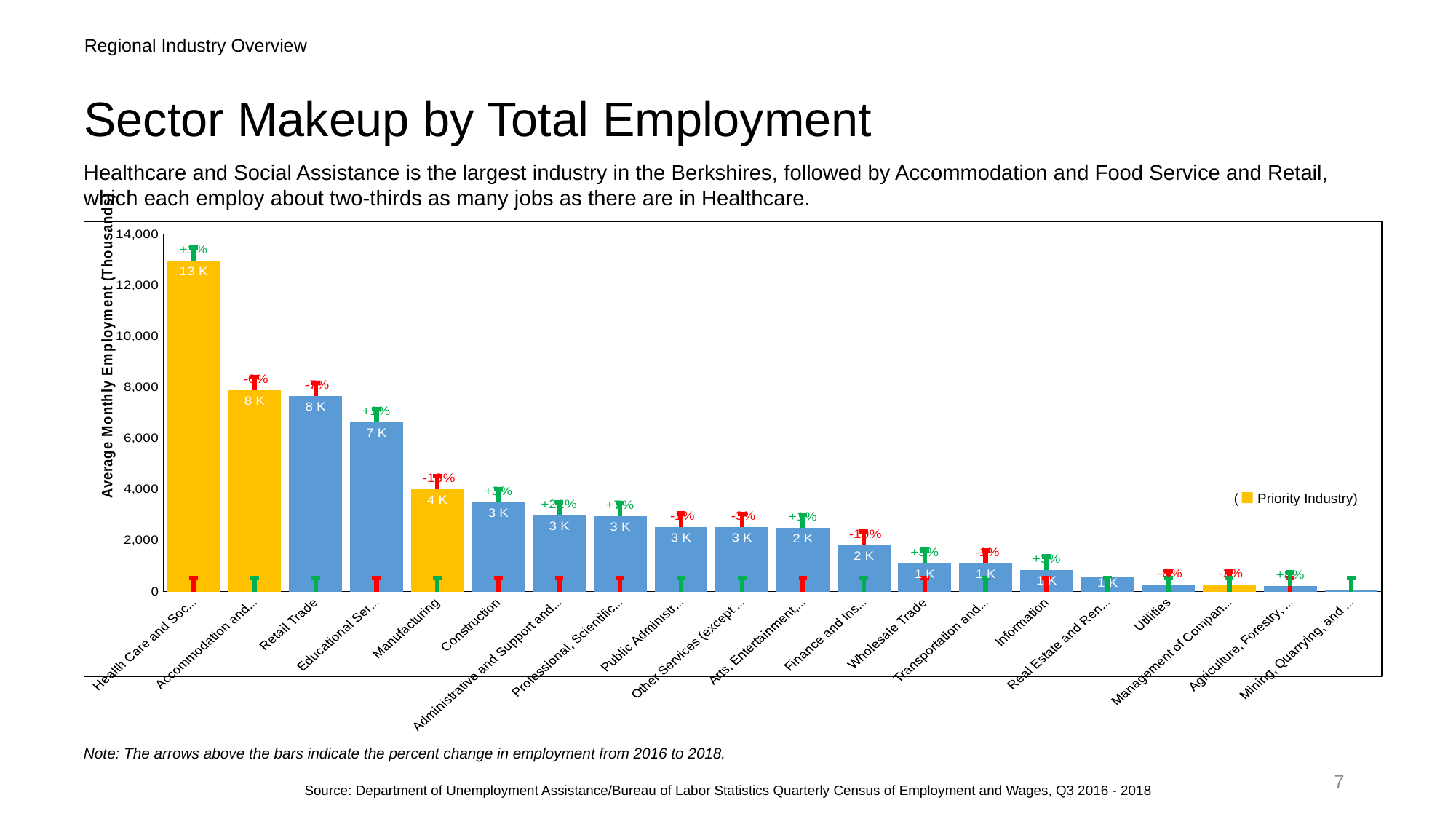
Do the bar values rise or fall moving from left to right along the x axis? Fall What is the data label on the Construction bar? 3 K How many industry categories are plotted on the x axis? 20 What is the data label on the Retail Trade bar? 8 K Which industry has the highest average monthly employment? Health Care and Soc... Which industry has the lowest average monthly employment? Mining, Quarrying, and ... Which is larger, the value for Health Care and Soc... or the value for Accommodation and...? Health Care and Soc... What is the data label on the Manufacturing bar? 4 K Is the value for Wholesale Trade greater or less than 2,000? less Is the value for Educational Ser... greater or less than 6,000? greater What kind of chart is shown on the slide? Bar chart What does the legend say the yellow bars represent? Priority Industry